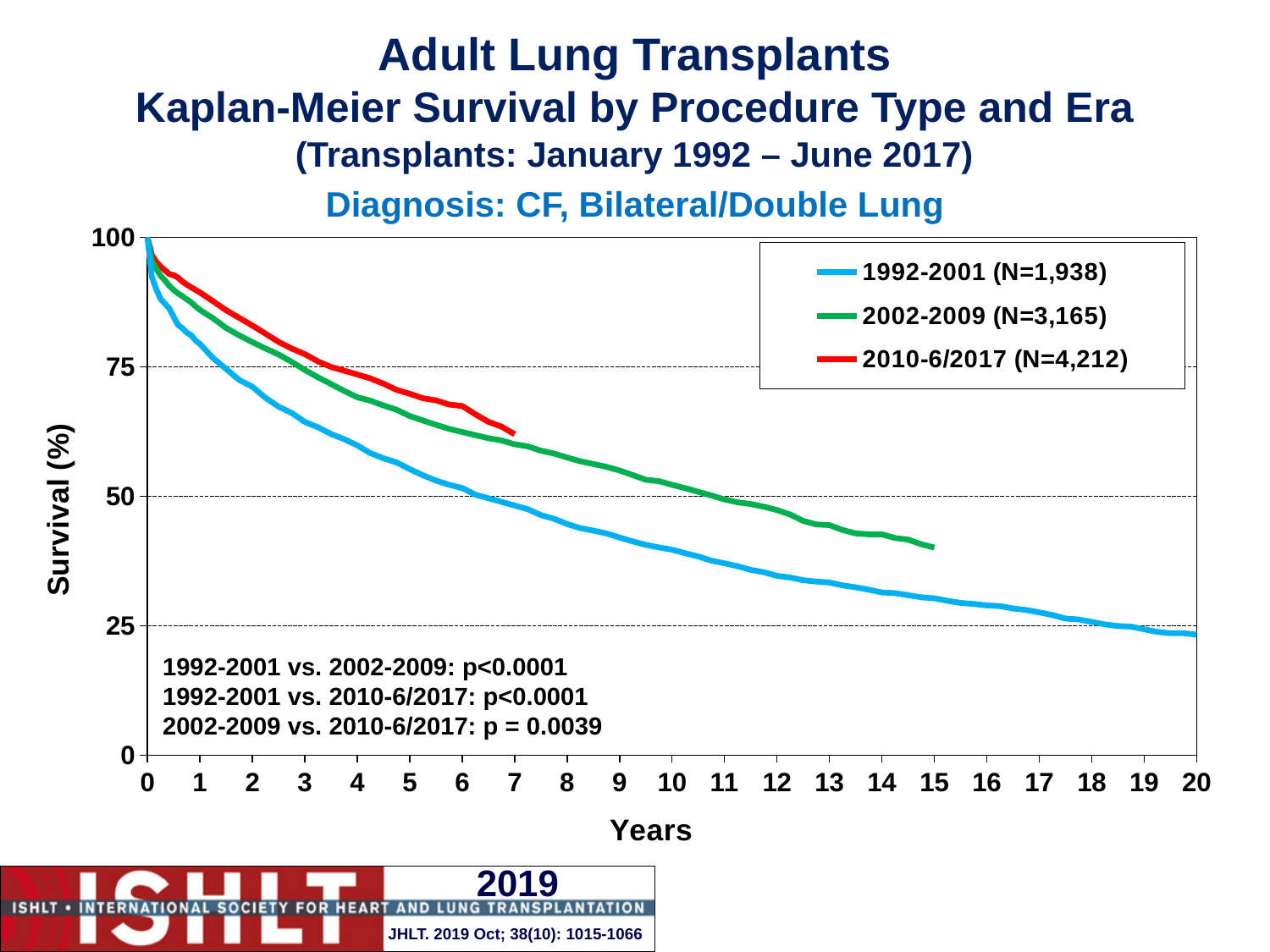
What is the N shown in the legend for the 2010-6/2017 series? 4,212 Is the survival value for the 2010-6/2017 series at 5 years greater or less than 50? greater At 5 years, which series has higher survival: 1992-2001 or 2010-6/2017? 2010-6/2017 Is the survival value for the 1992-2001 series at 20 years greater or less than 25? less Which series has the lowest survival at 10 years? 1992-2001 Is the survival value for the 2010-6/2017 series at 1 year greater or less than 75? greater How many series does the legend list? 3 What kind of chart is shown on the slide? line chart Which series has the highest survival at 5 years? 2010-6/2017 Do the survival curves rise or fall as years increase? fall